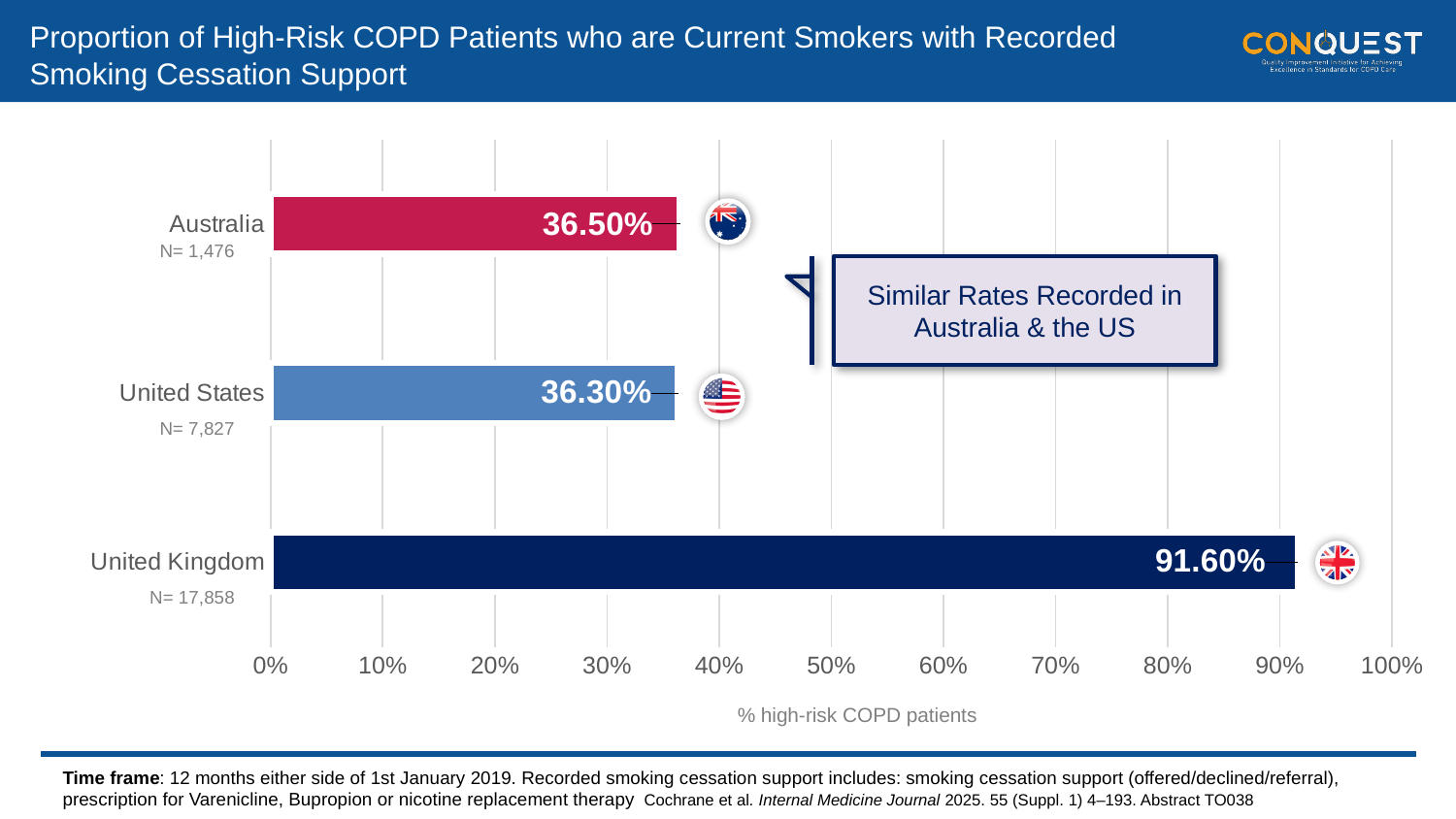
How many countries are shown in the chart? 3 What is the value for Australia? 36.50% What is the label on the x axis of the chart? % high-risk COPD patients What is the difference between the United Kingdom and Australia values? 55.10 percentage points Which is larger, the value for the United Kingdom or the United States? United Kingdom What is the value for the United Kingdom? 91.60% What is the value for the United States? 36.30% Which country has the highest proportion? United Kingdom What is the difference between the Australia and United States values? 0.20 percentage points Is the value for Australia greater or less than 40%? less What kind of chart is shown on the slide? Bar chart Is the value for the United Kingdom greater or less than 90%? greater